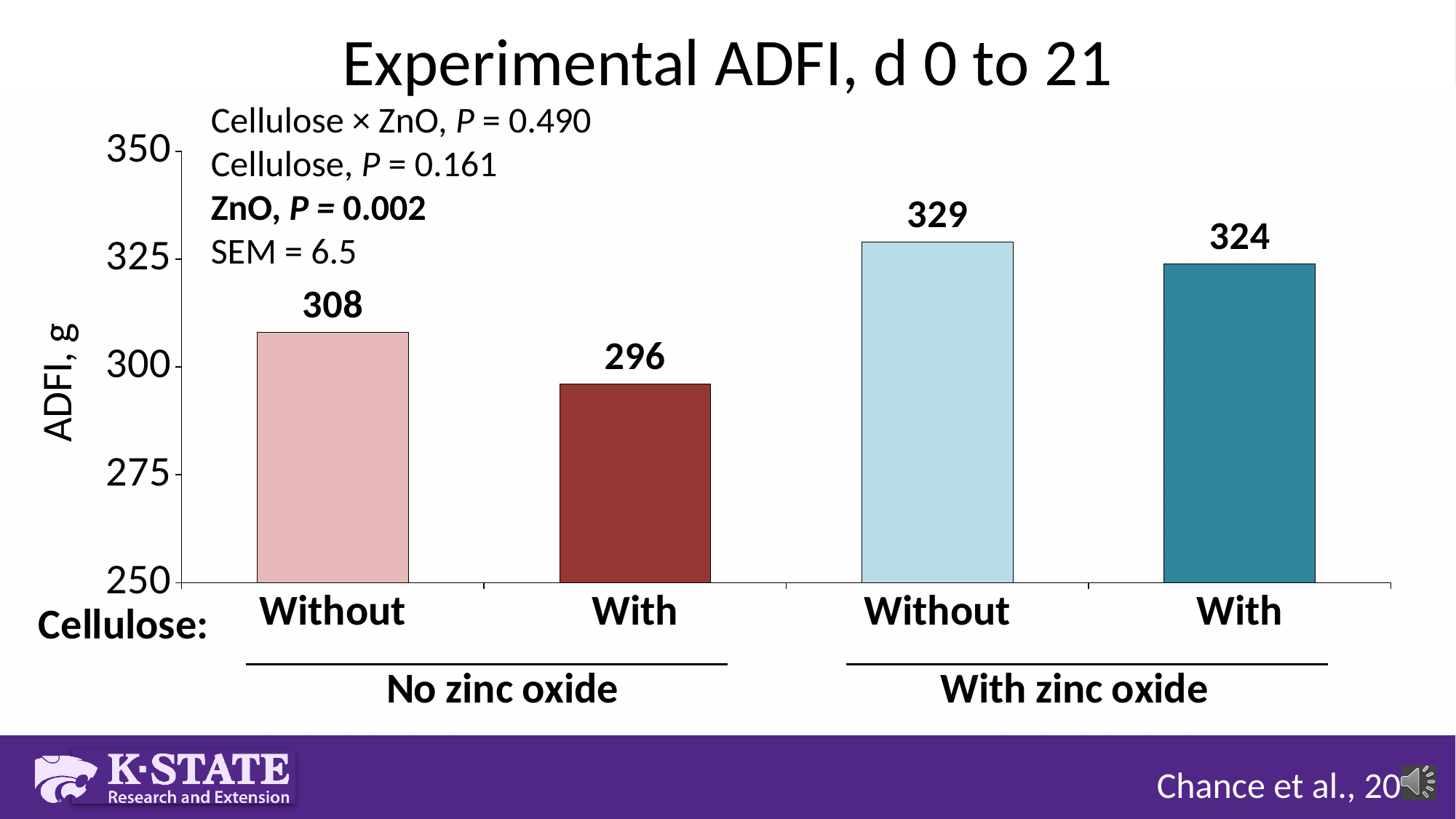
Is the ADFI value for 'With' cellulose in the 'No zinc oxide' group greater or less than 300? less Which bar has the highest ADFI value? Without cellulose, With zinc oxide (329) What is the difference in ADFI between the 'Without' cellulose bars in the 'With zinc oxide' and 'No zinc oxide' groups? 21 Which is larger: the ADFI for 'With' cellulose in the 'No zinc oxide' group or 'With' cellulose in the 'With zinc oxide' group? With cellulose, With zinc oxide (324) What is the title of the chart? Experimental ADFI, d 0 to 21 How many bars are shown in the chart? 4 What is the difference in ADFI between the 'Without' and 'With' cellulose bars in the 'No zinc oxide' group? 12 What is the P-value shown for ZnO on the chart? 0.002 Which bar has the lowest ADFI value? With cellulose, No zinc oxide (296) What is the ADFI value for the 'Without' cellulose bar in the 'No zinc oxide' group? 308 What is the ADFI value for the 'With' cellulose bar in the 'With zinc oxide' group? 324 What type of chart is shown on the slide? Bar chart